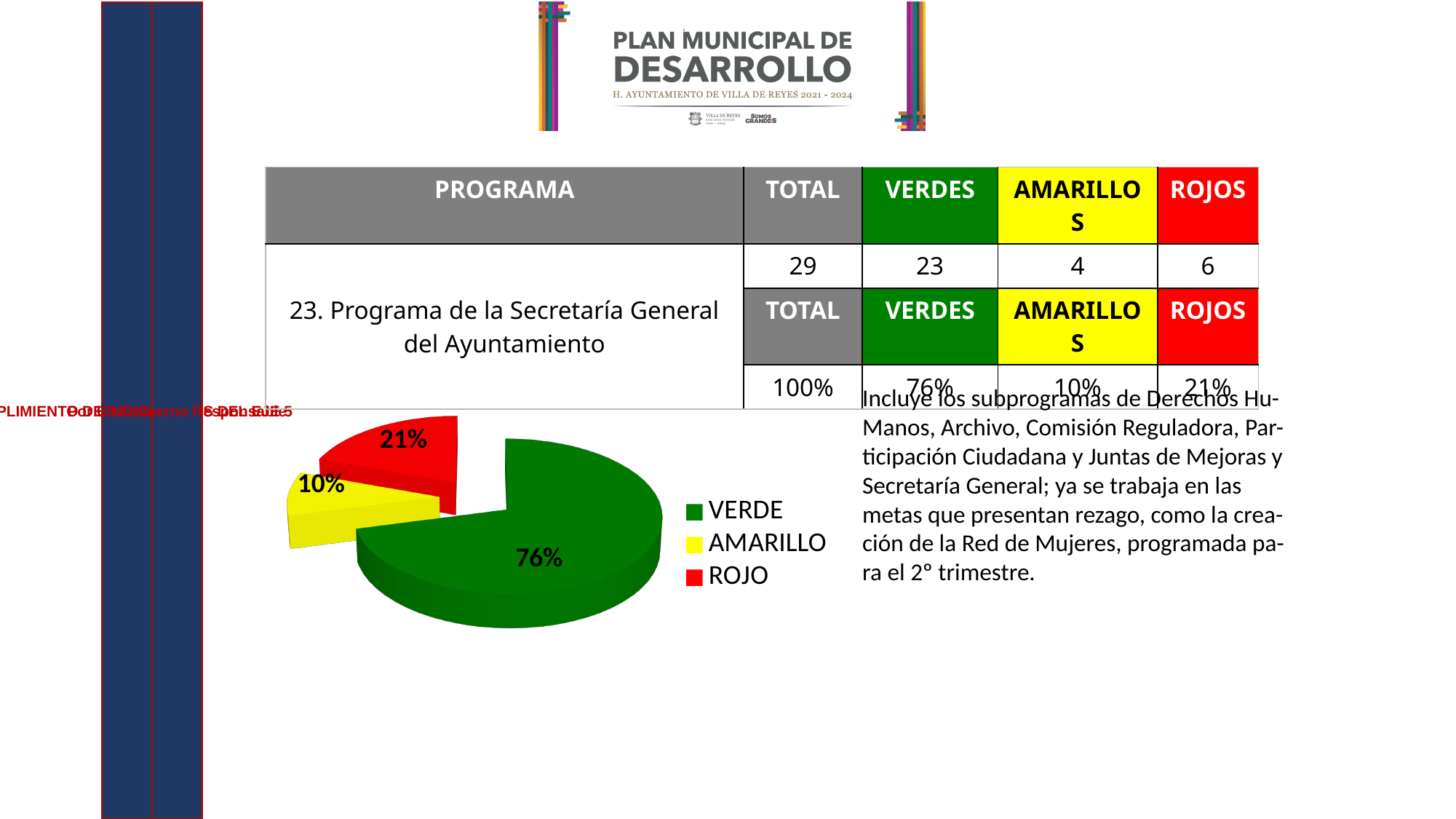
What kind of chart is shown on the slide? pie chart What percentage does the VERDE slice of the pie chart show? 76% Which slice of the pie chart is the largest? VERDE What percentage does the AMARILLO slice of the pie chart show? 10% What colour is the VERDE slice in the pie chart? green How many entries does the pie chart legend list? 3 What is the difference in percentage points between the VERDE slice and the ROJO slice? 55 Which is larger in the pie chart, the ROJO slice or the AMARILLO slice? ROJO Which slice of the pie chart is the smallest? AMARILLO How many slices does the pie chart have? 3 What colour is the ROJO slice in the pie chart? red What percentage does the ROJO slice of the pie chart show? 21%